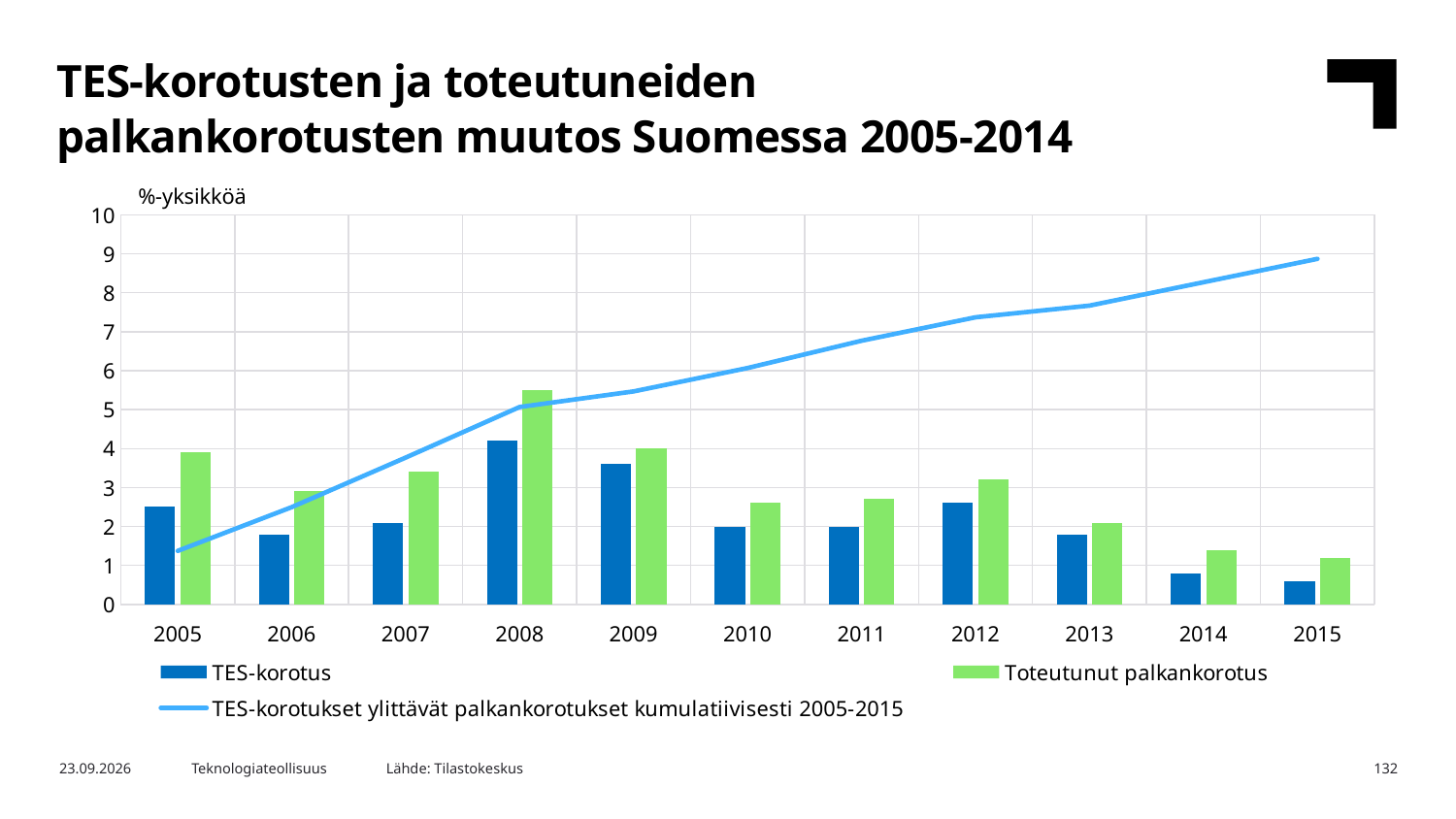
How many years are shown on the x axis? 11 In which year is the TES-korotus bar highest? 2008 Is the TES-korotus value for 2009 greater or less than 3? greater What kind of chart is shown on the slide? A bar chart combined with a line Is the value of the cumulative line (TES-korotukset ylittävät palkankorotukset kumulatiivisesti 2005-2015) in 2015 greater or less than 8? greater How many series does the legend list? 3 In which year is the Toteutunut palkankorotus bar highest? 2008 In 2005, which is larger: TES-korotus or Toteutunut palkankorotus? Toteutunut palkankorotus In which year is the TES-korotus bar lowest? 2015 Is the Toteutunut palkankorotus value for 2008 greater or less than 5? greater In which year is the Toteutunut palkankorotus bar lowest? 2015 Does the cumulative line rise or fall from 2005 to 2015? It rises